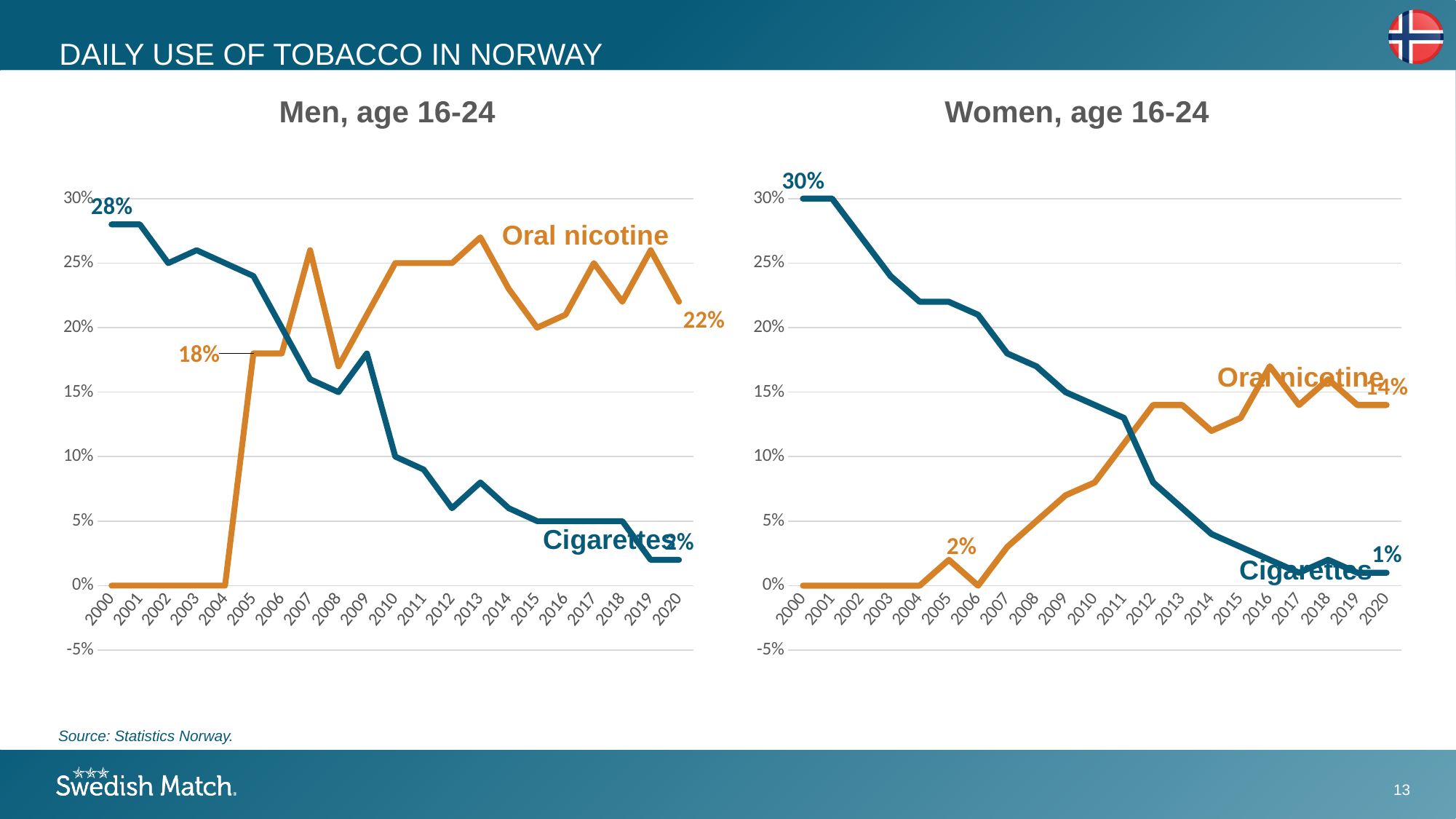
In the Women, age 16-24 chart, what was the daily cigarette use in 2000? 30% In the Men, age 16-24 chart, what was the oral nicotine value in 2020? 22% What kind of chart is used for the Men, age 16-24 panel? line chart In the Women, age 16-24 chart, how does cigarette use change from 2000 to 2020? It falls In the Men, age 16-24 chart, which series is higher in 2020, Oral nicotine or Cigarettes? Oral nicotine In the Women, age 16-24 chart, what was the daily cigarette use in 2020? 1% In the Women, age 16-24 chart, by how many percentage points did daily cigarette use fall from 2000 to 2020? 29 percentage points In the Men, age 16-24 chart, what was the daily cigarette use in 2000? 28% How many series are plotted in the Women, age 16-24 chart? 2 In the Men, age 16-24 chart, what was the oral nicotine value in 2005? 18% In the Men, age 16-24 chart, is the oral nicotine value in 2013 greater or less than 25%? greater In the Women, age 16-24 chart, what was the oral nicotine value in 2020? 14%